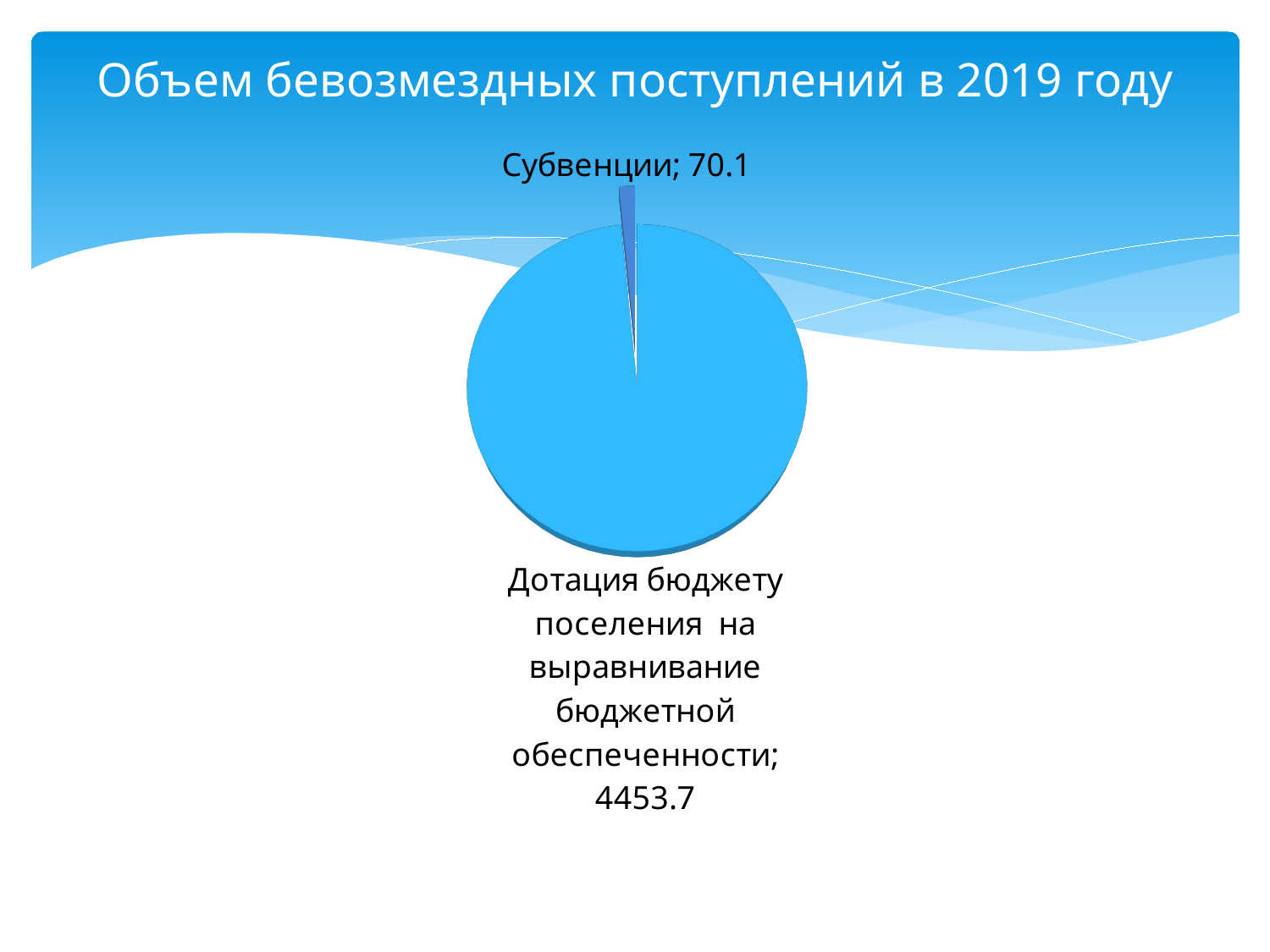
Which category has the largest slice of the pie? Дотация бюджету поселения на выравнивание бюджетной обеспеченности What is the value for Дотация бюджету поселения на выравнивание бюджетной обеспеченности? 4453.7 What is the title of the chart? Объем бевозмездных поступлений в 2019 году How many slices does the pie chart have? 2 Which category has the smallest slice of the pie? Субвенции What kind of chart is shown on the slide? pie chart What is the total of the two values shown in the pie chart? 4523.8 Which year does the chart title refer to? 2019 Which is larger: the value for Субвенции or the value for Дотация бюджету поселения на выравнивание бюджетной обеспеченности? Дотация бюджету поселения на выравнивание бюджетной обеспеченности What is the difference between the value for Дотация бюджету поселения на выравнивание бюджетной обеспеченности and the value for Субвенции? 4383.6 What is the value for Субвенции? 70.1